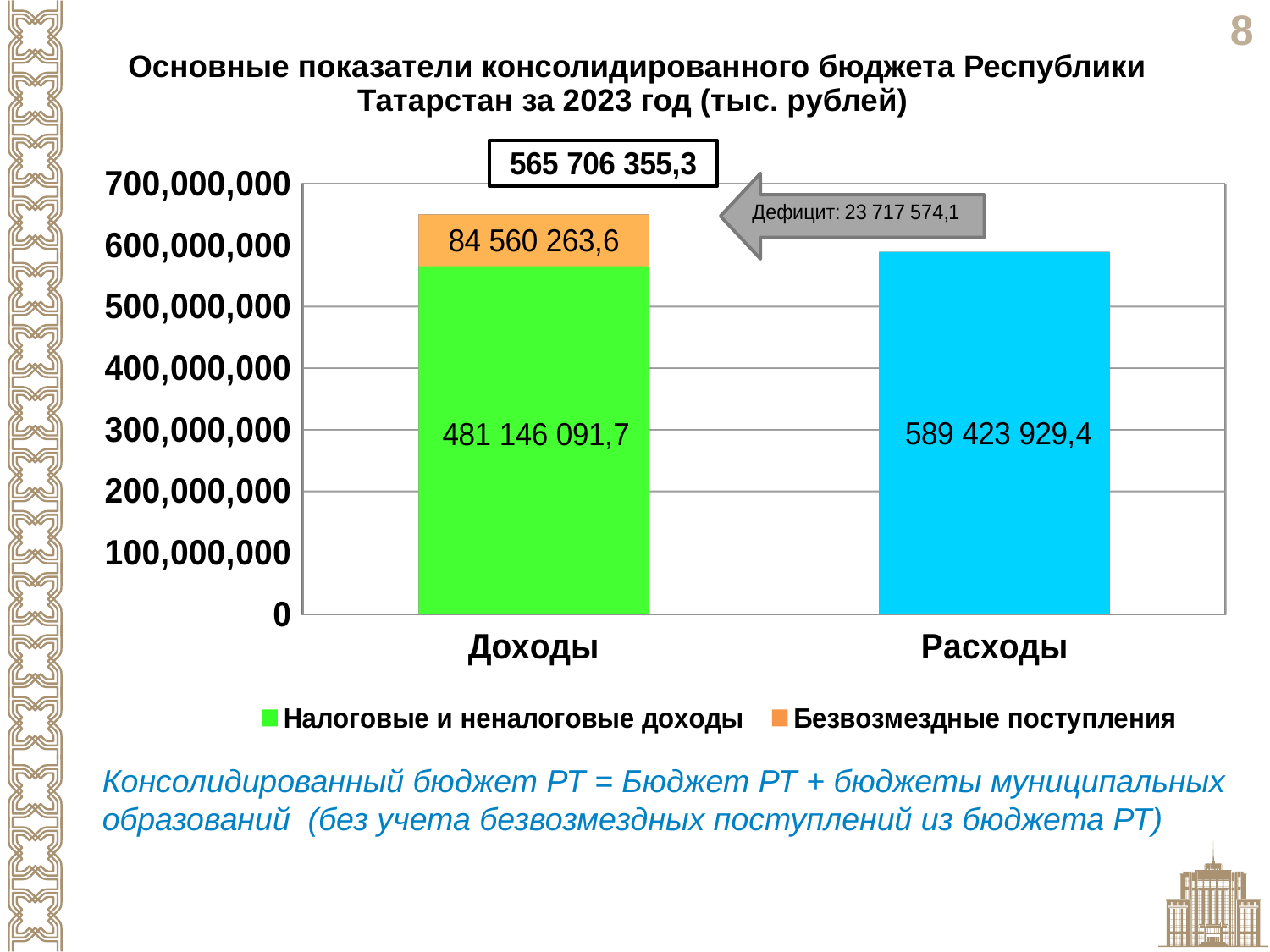
How many categories are shown on the x axis of the chart? 2 What is the value of the 'Налоговые и неналоговые доходы' segment in the 'Доходы' bar? 481 146 091,7 What is the value of the 'Безвозмездные поступления' segment in the 'Доходы' bar? 84 560 263,6 What is the total of the stacked 'Доходы' bar? 565 706 355,3 How many series does the legend list? 2 Is the value for 'Расходы' greater or less than 500,000,000? greater What is the value shown for 'Расходы'? 589 423 929,4 What kind of chart is shown on the slide? Stacked bar chart What deficit value is shown in the arrow callout on the chart? 23 717 574,1 Is the 'Налоговые и неналоговые доходы' segment greater or less than 400,000,000? greater Which is larger, the total for 'Доходы' or the value for 'Расходы'? Расходы What is the difference between 'Расходы' (589 423 929,4) and the total 'Доходы' (565 706 355,3)? 23 717 574,1